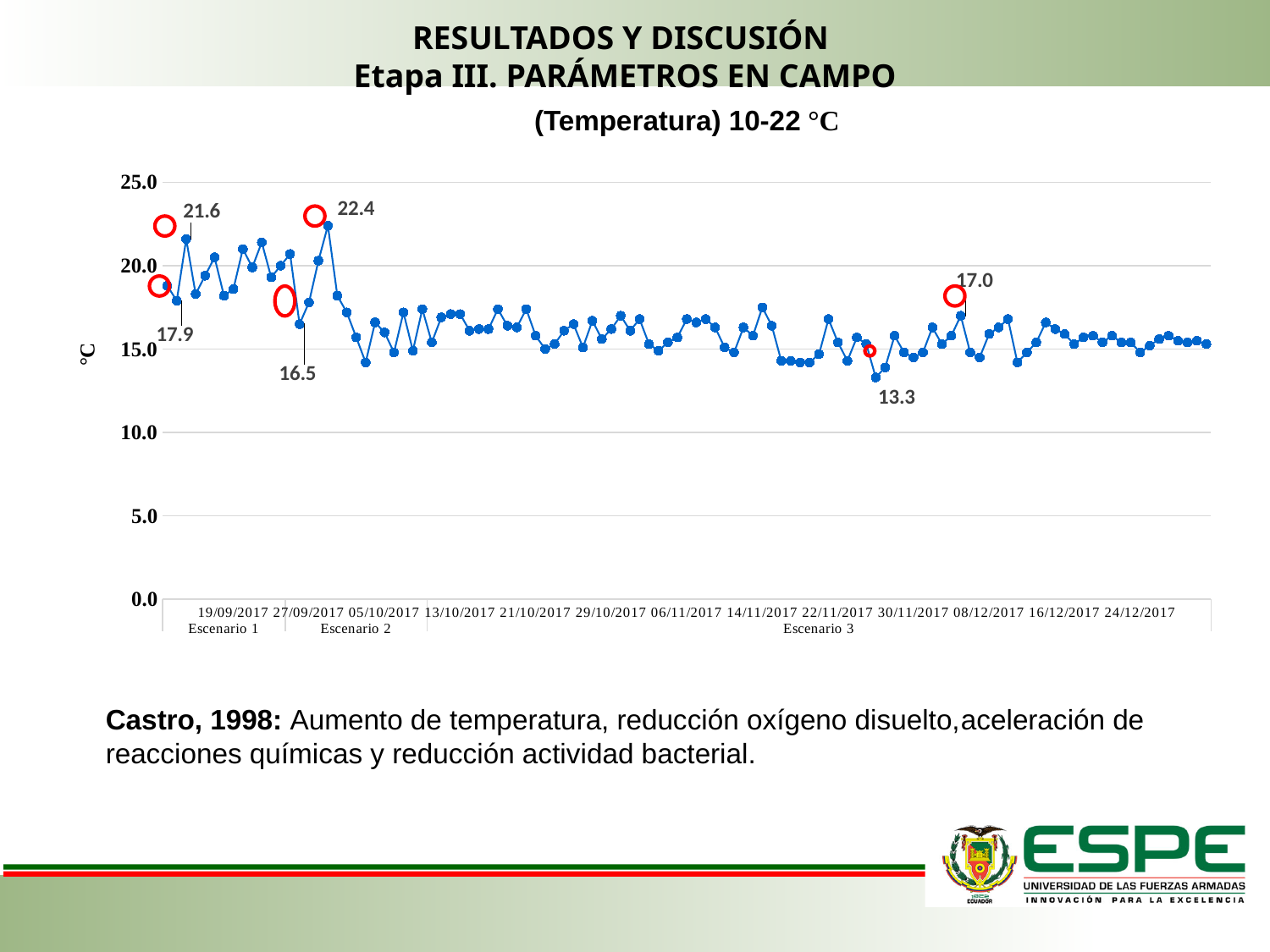
Which labeled value is larger, 21.6 or 17.0? 21.6 What kind of chart is shown on the slide? line chart What is the difference between the highest labeled value (22.4) and the lowest labeled value (13.3)? 9.1 How many scenarios (Escenarios) are marked along the x axis? 3 Is the labeled point 22.4 greater or less than 20.0 on the y axis? greater Is the labeled point 13.3 greater or less than 15.0 on the y axis? less What is the highest labeled temperature value on the chart? 22.4 What is the lowest labeled temperature value on the chart? 13.3 What is the label of the y axis? °C What is the difference between the labeled values 21.6 and 17.9? 3.7 Do the temperature values generally rise or fall from the start of the series to the end? fall What is the first date shown on the x axis? 19/09/2017